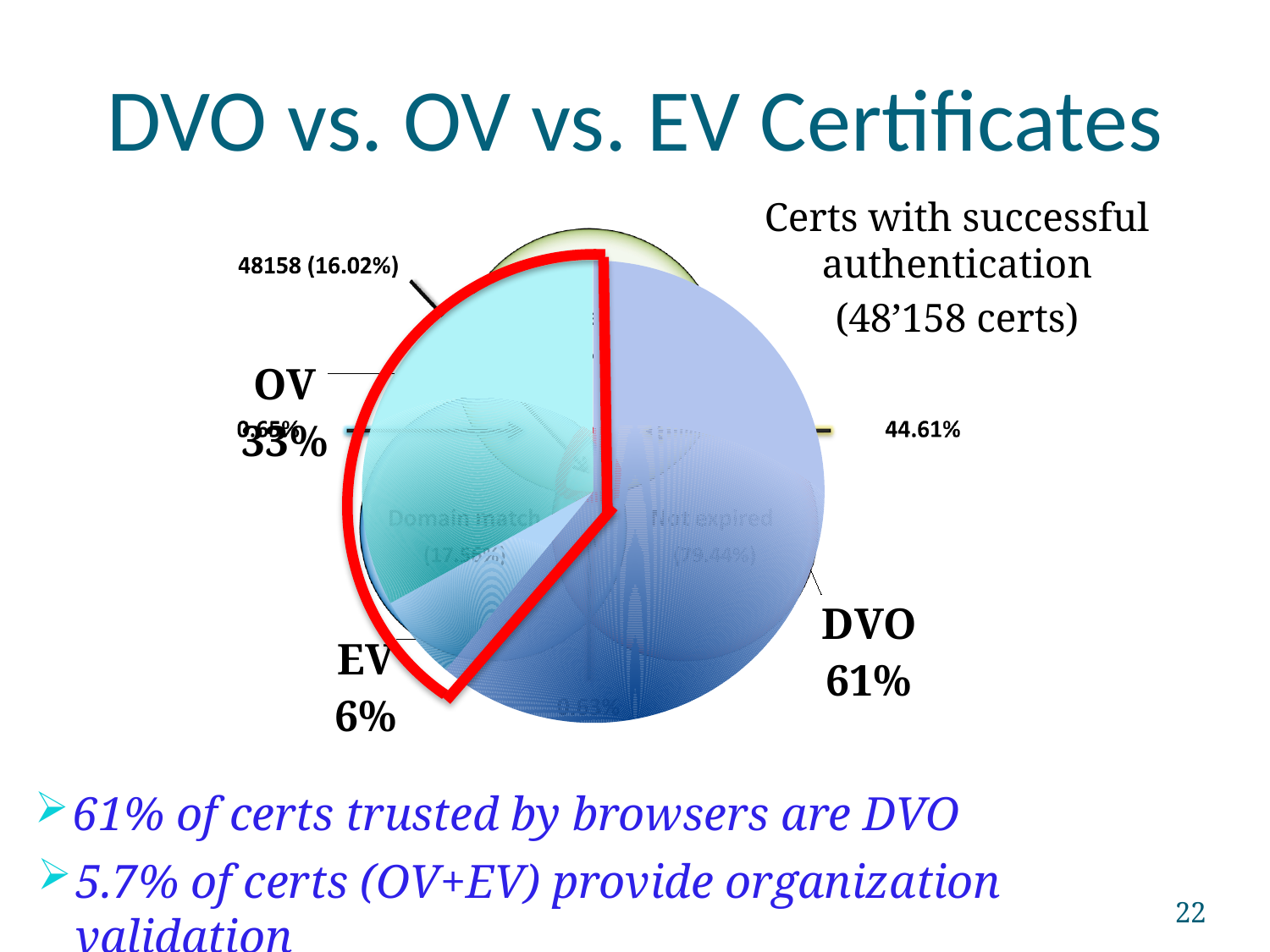
What share of the pie chart is labelled DVO? 61% According to the text next to the chart, how many certs had successful authentication? 48'158 certs Which certificate type has the smallest slice of the pie chart? EV Which slice is larger, OV or EV? OV Which certificate type has the largest slice of the pie chart? DVO What kind of chart is shown on the slide? Pie chart What share of the pie chart is labelled EV? 6% What is the difference in percentage points between the OV slice and the EV slice? 27% How many certificate types are labelled on the pie chart? 3 Which slice is larger, DVO or OV? DVO What is the difference in percentage points between the DVO slice and the OV slice? 28% What share of the pie chart is labelled OV? 33%